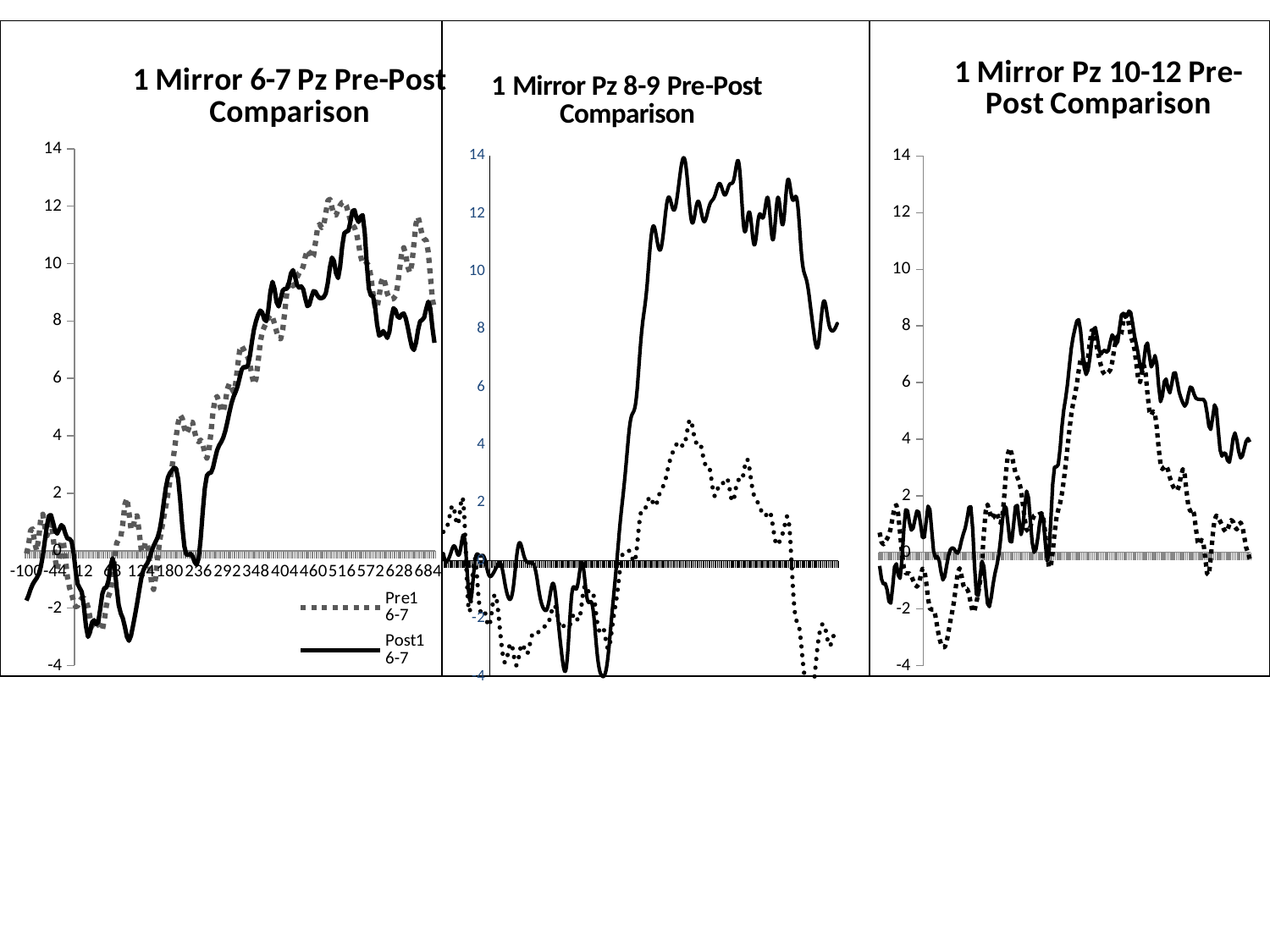
In the "1 Mirror 6-7 Pz Pre-Post Comparison" chart, do the values of the Post1 6-7 series generally rise or fall from the left of the x axis to the right? rise In the "1 Mirror 6-7 Pz Pre-Post Comparison" chart, is the highest value of the Post1 6-7 series greater or less than 10? greater What is the title of the middle chart on the slide? 1 Mirror Pz 8-9 Pre-Post Comparison In the "1 Mirror Pz 8-9 Pre-Post Comparison" chart, is the highest value of the solid line greater or less than 12? greater In the "1 Mirror Pz 10-12 Pre-Post Comparison" chart, at the right end of the x axis, which line is higher, the solid line or the dotted line? the solid line How many charts are shown on the slide? 3 How many series does the legend of the "1 Mirror 6-7 Pz Pre-Post Comparison" chart list? 2 In the "1 Mirror Pz 8-9 Pre-Post Comparison" chart, is the highest value of the dotted line greater or less than 6? less In the "1 Mirror 6-7 Pz Pre-Post Comparison" chart, which series is drawn with a dotted line? Pre1 6-7 In the "1 Mirror Pz 8-9 Pre-Post Comparison" chart, which line reaches a higher peak, the solid line or the dotted line? the solid line What kind of chart is the "1 Mirror 6-7 Pz Pre-Post Comparison" chart? line chart